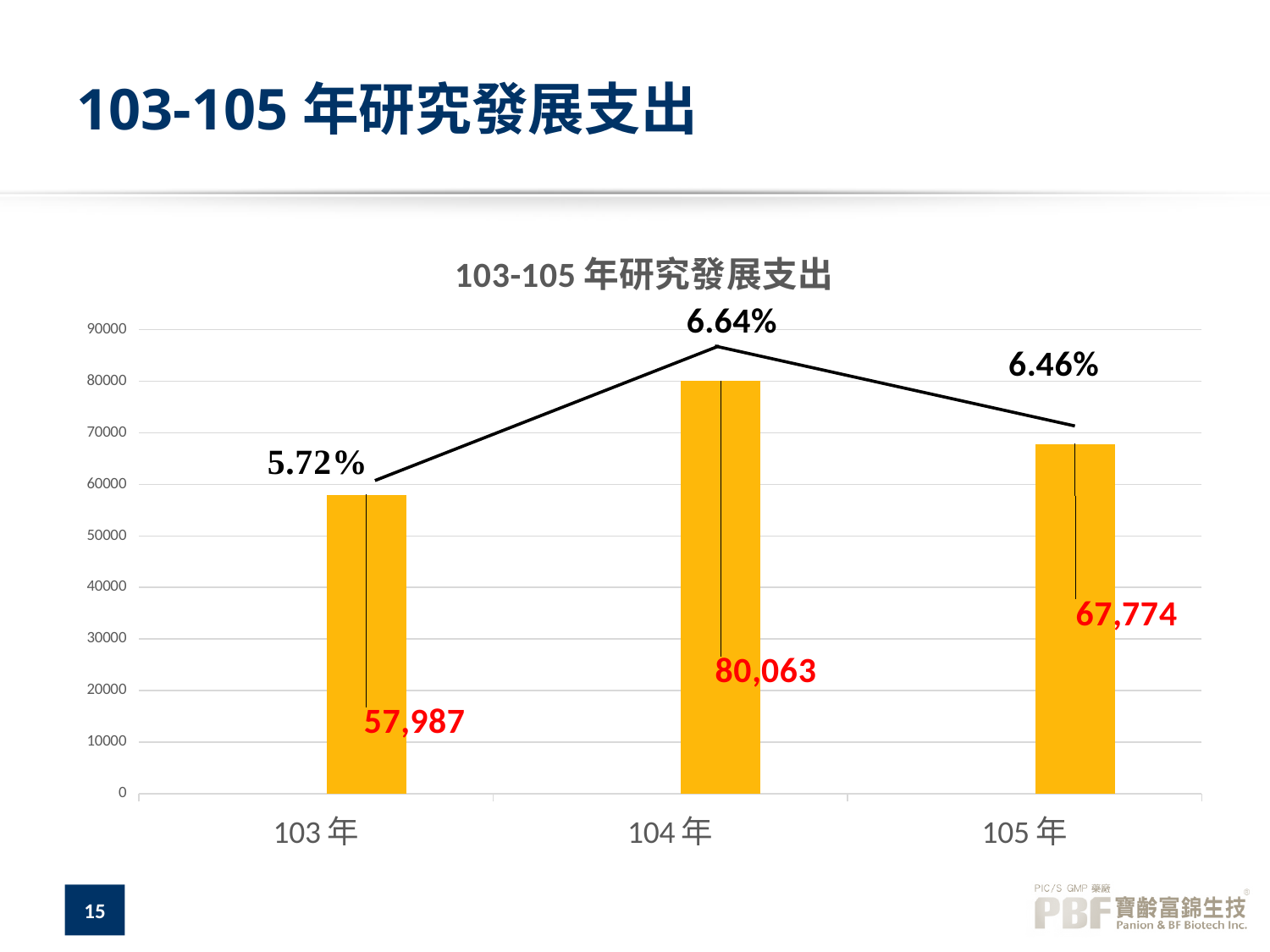
How many years are shown on the x axis of the chart? 3 Which year has the highest research and development expenditure? 104 年 What percentage is shown above the bar for 103 年? 5.72% Is the expenditure for 105 年 greater or less than 60000? greater What percentage is shown above the bar for 104 年? 6.64% What is the title of the chart? 103-105 年研究發展支出 What is the research and development expenditure for 104 年? 80,063 Which year has the lowest research and development expenditure? 103 年 What percentage is shown above the bar for 105 年? 6.46% What is the difference in expenditure between 104 年 and 103 年? 22,076 What is the research and development expenditure for 105 年? 67,774 What is the research and development expenditure for 103 年? 57,987